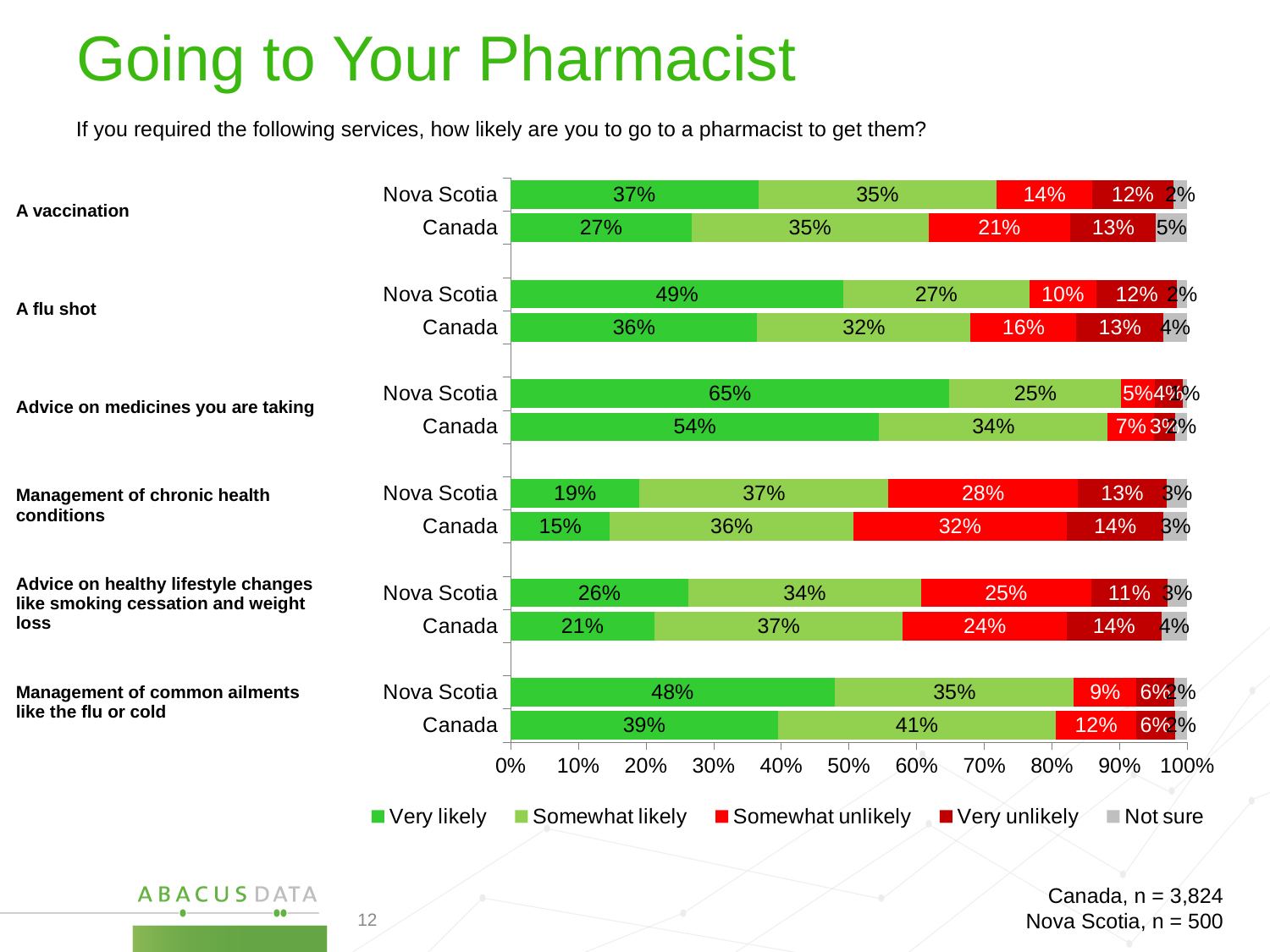
What percentage of Canada respondents are somewhat unlikely to go to a pharmacist for management of chronic health conditions? 32% Which bar has the lowest 'Very likely' value? Management of chronic health conditions, Canada (15%) How many series does the legend list? 5 How many bars are plotted on the chart? 12 For a flu shot, which has the larger 'Very likely' value, Nova Scotia or Canada? Nova Scotia What is the combined 'Very likely' and 'Somewhat likely' share for Nova Scotia for a flu shot? 76% What kind of chart is shown on the slide? Stacked bar chart What percentage of Nova Scotia respondents are very likely to go to a pharmacist for a flu shot? 49% How many percentage points higher is the 'Very likely' value for Nova Scotia than for Canada for a vaccination? 10 percentage points Which bar has the highest 'Very likely' value? Advice on medicines you are taking, Nova Scotia (65%) What is the 'Not sure' value for Canada for a vaccination? 5% Which colour represents 'Somewhat unlikely' in the legend? Red